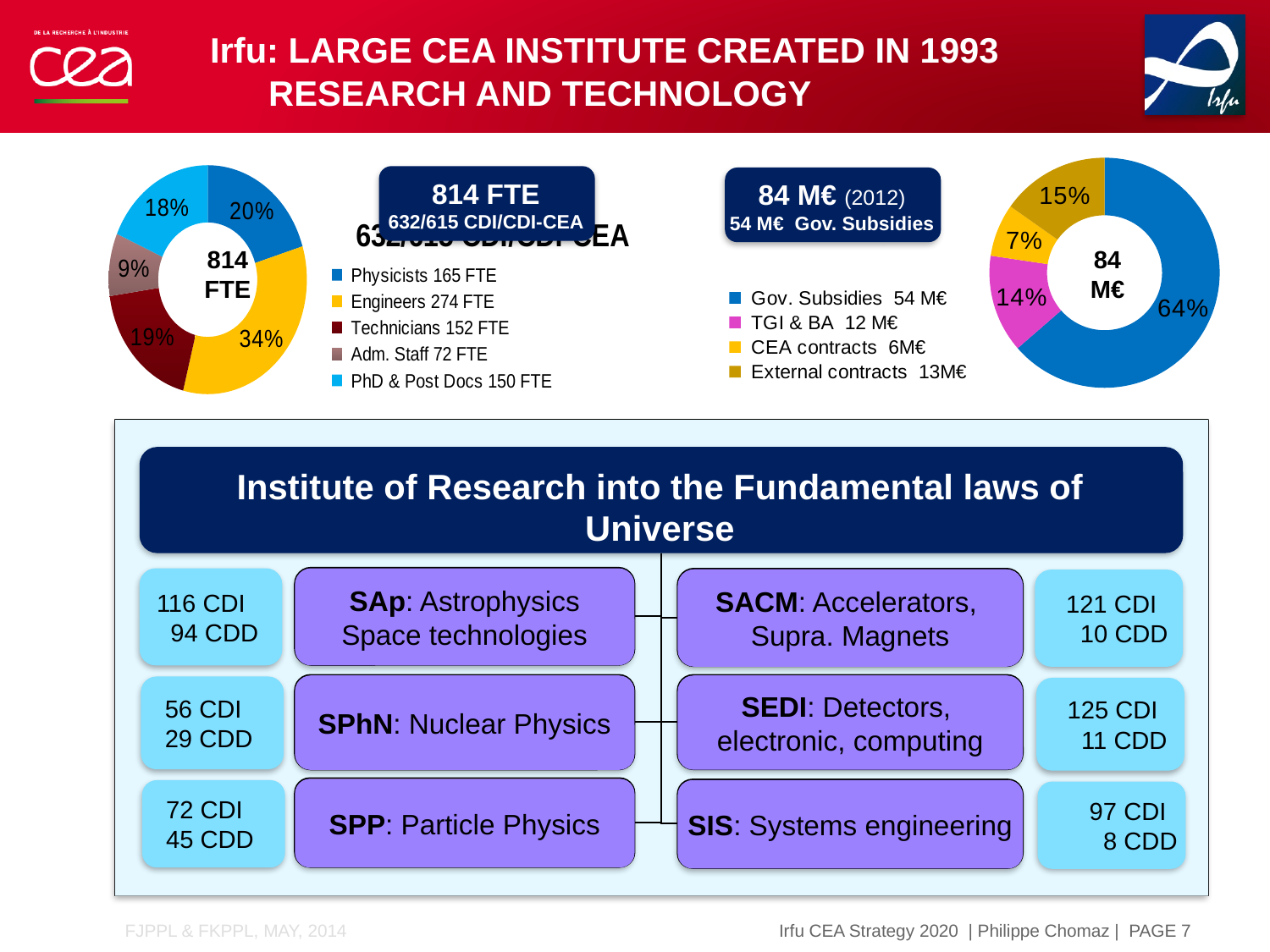
In the left doughnut chart (814 FTE), how many categories does the legend list? 5 What type of chart is used for the 84 M€ budget breakdown on the right? Doughnut (pie) chart In the left doughnut chart (814 FTE), which category has the largest share? Engineers In the right doughnut chart (84 M€), what value does the legend give for External contracts? 13M€ In the left doughnut chart (814 FTE), what is the difference in FTE between Engineers and Physicists? 109 FTE In the right doughnut chart (84 M€), what percentage share do Gov. Subsidies have? 64% In the left doughnut chart (814 FTE), which category has the smallest share? Adm. Staff In the left doughnut chart (814 FTE), what percentage share do Engineers have? 34% In the left doughnut chart (814 FTE), how many FTE does the legend give for Technicians? 152 FTE In the right doughnut chart (84 M€), how many categories does the legend list? 4 In the right doughnut chart (84 M€), which category has the smallest share? CEA contracts In the right doughnut chart (84 M€), which is larger, TGI & BA or External contracts? External contracts